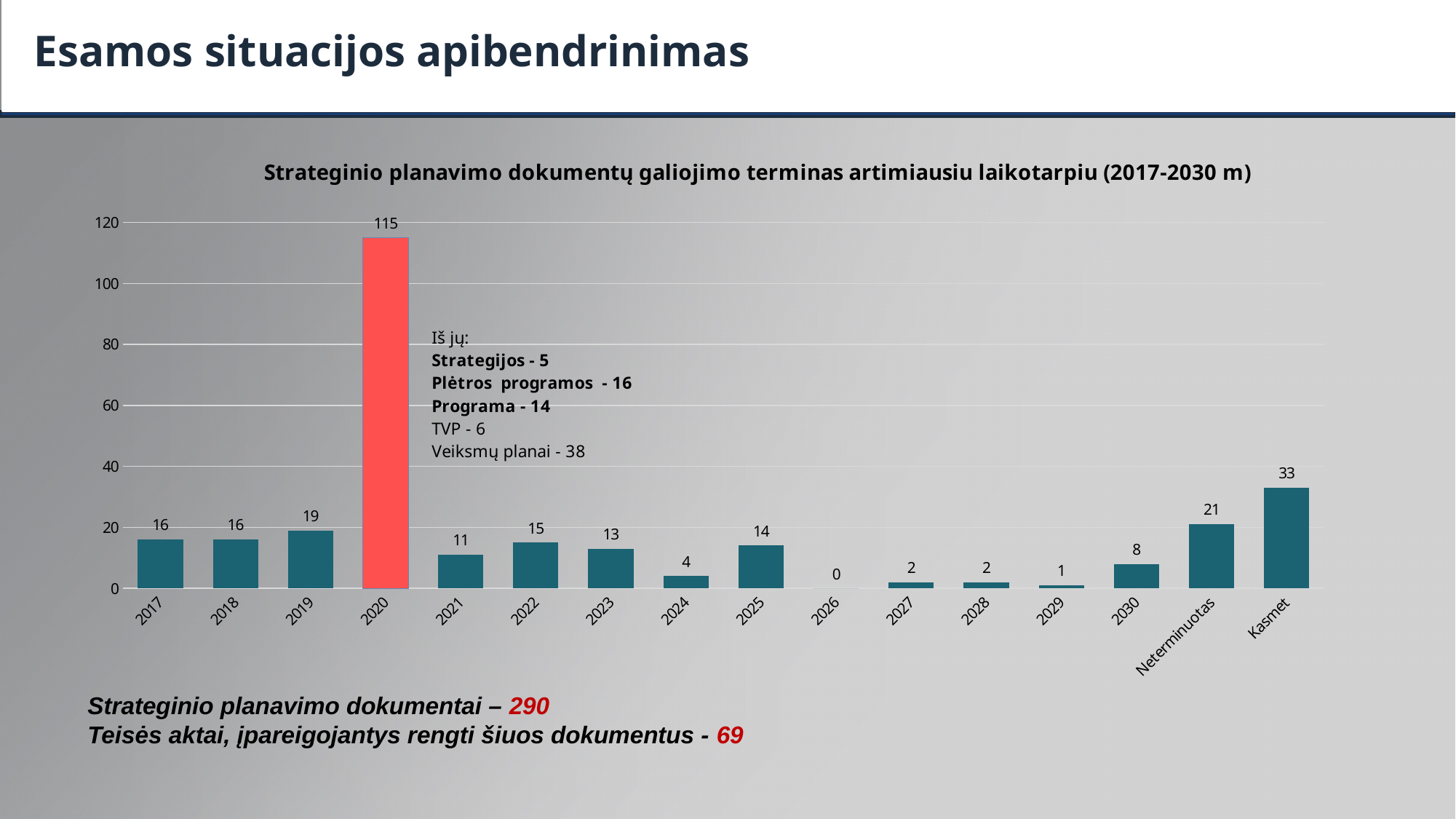
What is the title of the chart? Strateginio planavimo dokumentų galiojimo terminas artimiausiu laikotarpiu (2017-2030 m) What is the value for Kasmet? 33 Which category has the highest value? 2020 What kind of chart is shown on the slide? Bar chart Which category has the lowest value? 2026 Which is larger, the value for 2022 or the value for 2023? 2022 How many categories are shown on the x axis? 16 What is the value for 2020? 115 What is the difference between the values for 2020 and 2019? 96 What is the value for 2026? 0 What is the value for Neterminuotas? 21 What is the difference between the values for Kasmet and Neterminuotas? 12